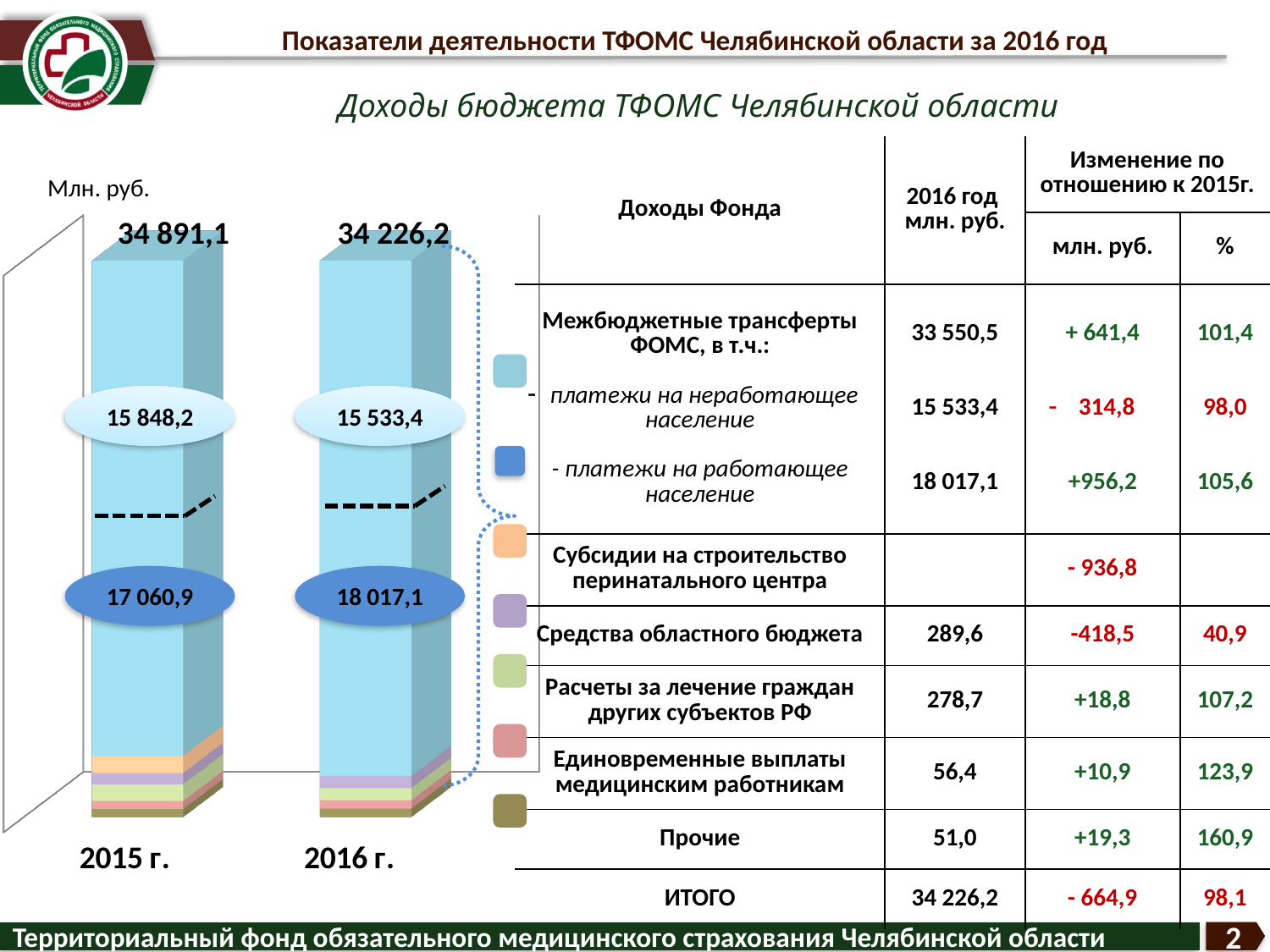
How many bars (years) does the chart show? 2 Does the total bar value rise or fall from 2015 г. to 2016 г.? fall What is the total value shown above the 2016 г. bar? 34 226,2 What is the total value shown above the 2015 г. bar? 34 891,1 What is the value of the light blue segment (платежи на неработающее население) in the 2015 г. bar? 15 848,2 What is the value of the dark blue segment (платежи на работающее население) in the 2016 г. bar? 18 017,1 What kind of chart is shown on the left of the slide? stacked bar chart By how much does the total for 2015 г. exceed the total for 2016 г.? 664,9 What is the difference between the dark blue segment values (платежи на работающее население) for 2016 г. and 2015 г.? 956,2 Which year has the larger total, 2015 г. or 2016 г.? 2015 г. In what units are the chart values given, according to the label above the chart? Млн. руб. What is the difference between the light blue segment values (платежи на неработающее население) for 2015 г. and 2016 г.? 314,8